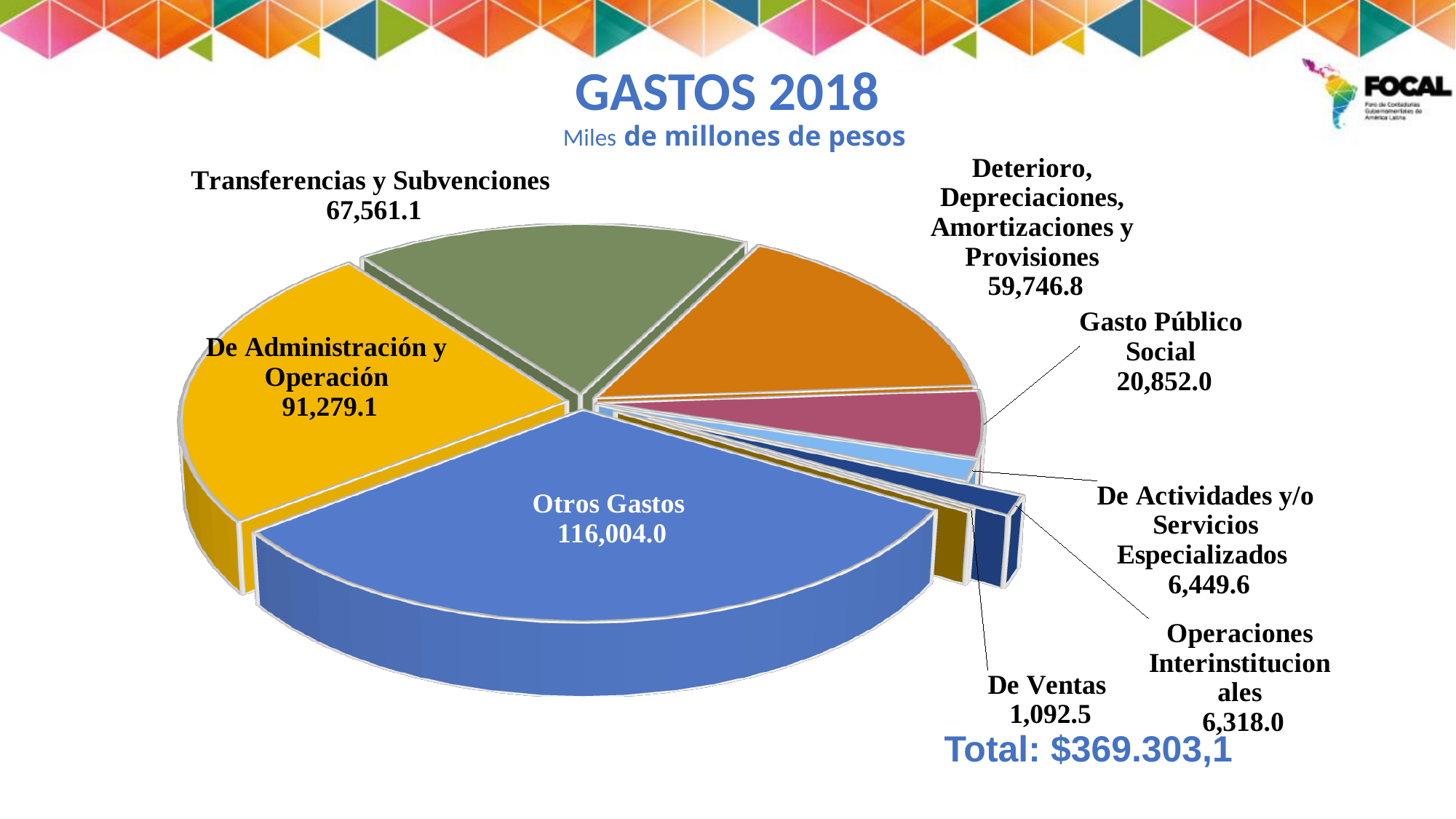
What is the value for Operaciones Interinstitucionales? 6,318.0 How many categories (slices) does the pie chart have? 8 What is the difference between Transferencias y Subvenciones and Deterioro, Depreciaciones, Amortizaciones y Provisiones? 7,814.3 What is the value for Otros Gastos? 116,004.0 Which is larger, Transferencias y Subvenciones or Deterioro, Depreciaciones, Amortizaciones y Provisiones? Transferencias y Subvenciones What is the difference between Otros Gastos and De Administración y Operación? 24,724.9 Which category has the smallest value? De Ventas Which category has the largest value? Otros Gastos What is the title of the chart? GASTOS 2018 What is the value for De Administración y Operación? 91,279.1 What kind of chart is shown on the slide? Pie chart What is the value for Gasto Público Social? 20,852.0